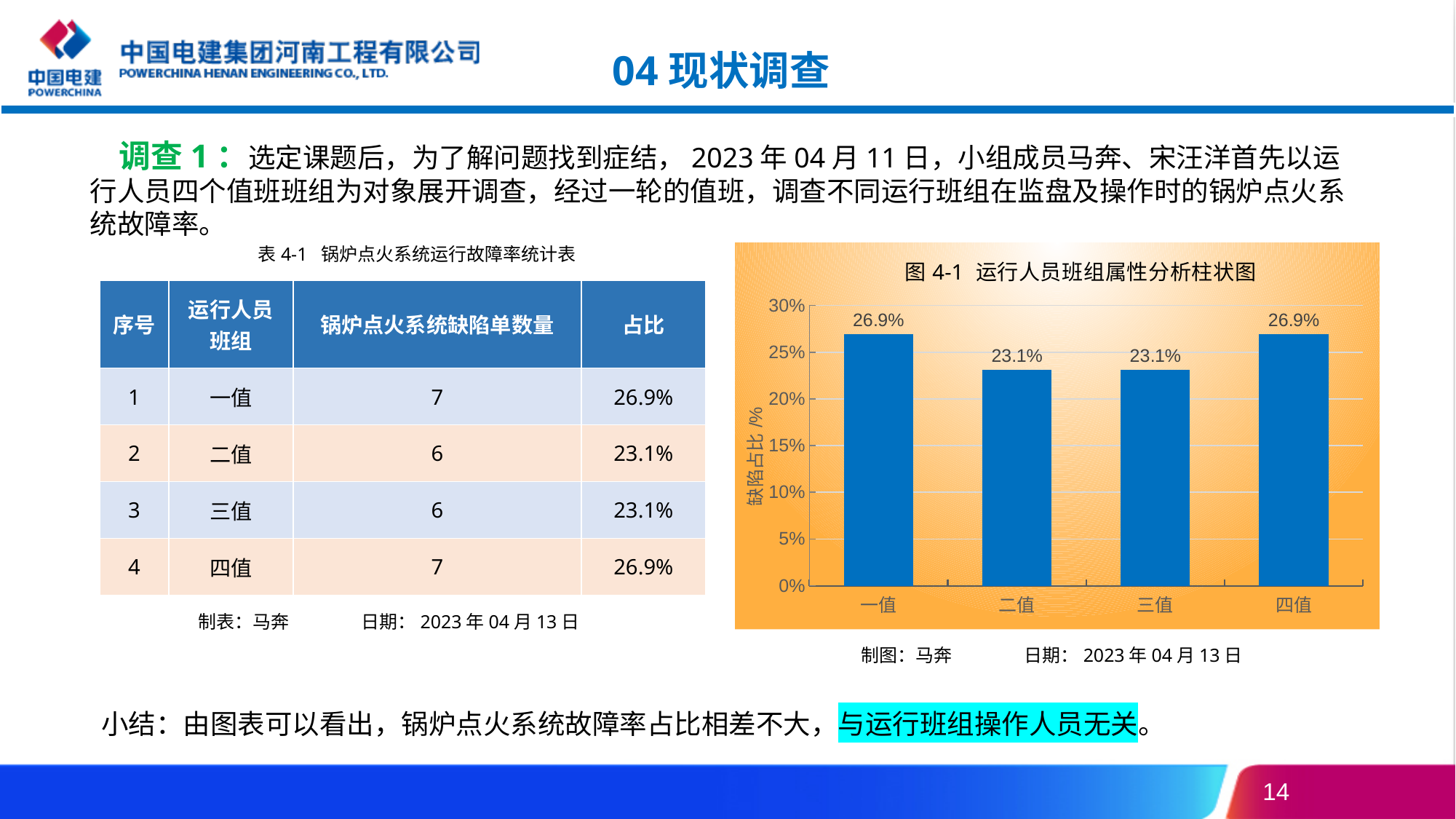
Which is larger, the value for 一值 or the value for 二值? 一值 What kind of chart is shown on the slide? bar chart How many categories are shown on the x axis of the chart? 4 What is the value for 一值 in the chart? 26.9% What is the value for 二值 in the chart? 23.1% Is the value for 二值 greater or less than 25%? less What is the value for 四值 in the chart? 26.9% Which is larger, the value for 三值 or the value for 四值? 四值 What is the title of the chart? 图 4-1 运行人员班组属性分析柱状图 What is the value for 三值 in the chart? 23.1% What is the difference between the values for 一值 and 二值? 3.8% Is the value for 四值 greater or less than 25%? greater